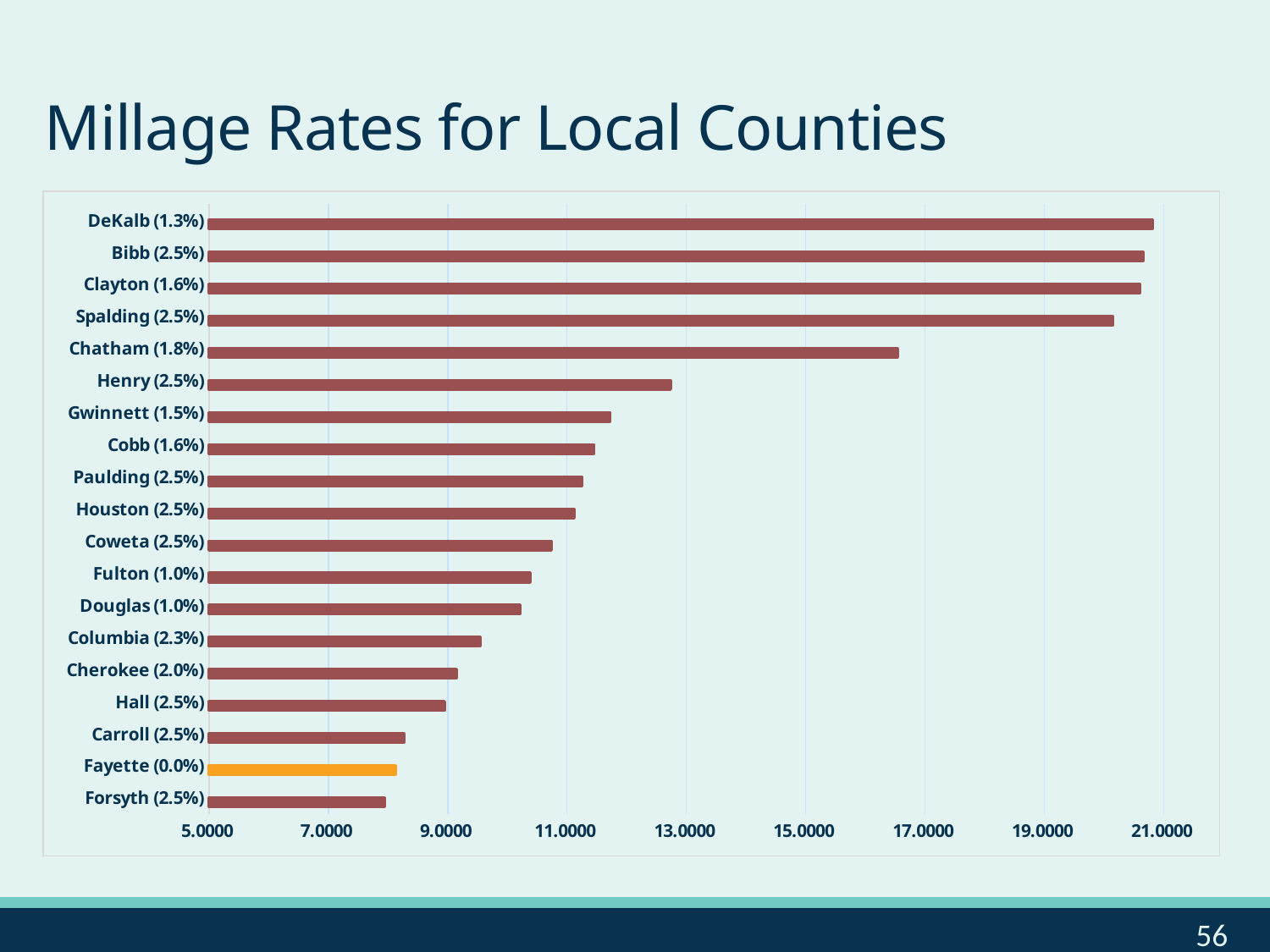
Which has the larger millage rate, Chatham (1.8%) or Henry (2.5%)? Chatham (1.8%) What is the title of the chart? Millage Rates for Local Counties How many counties are plotted in the chart? 19 Is the value for Spalding (2.5%) greater or less than 19.0000? greater Is the value for Chatham (1.8%) greater or less than 15.0000? greater Is the value for Fulton (1.0%) greater or less than 11.0000? less Which has the larger millage rate, Carroll (2.5%) or Columbia (2.3%)? Columbia (2.3%) Do the bar values increase or decrease going from the top of the chart to the bottom? decrease What kind of chart is shown on the slide? bar chart Which county's bar is shown in a different colour (orange) from the others? Fayette (0.0%)